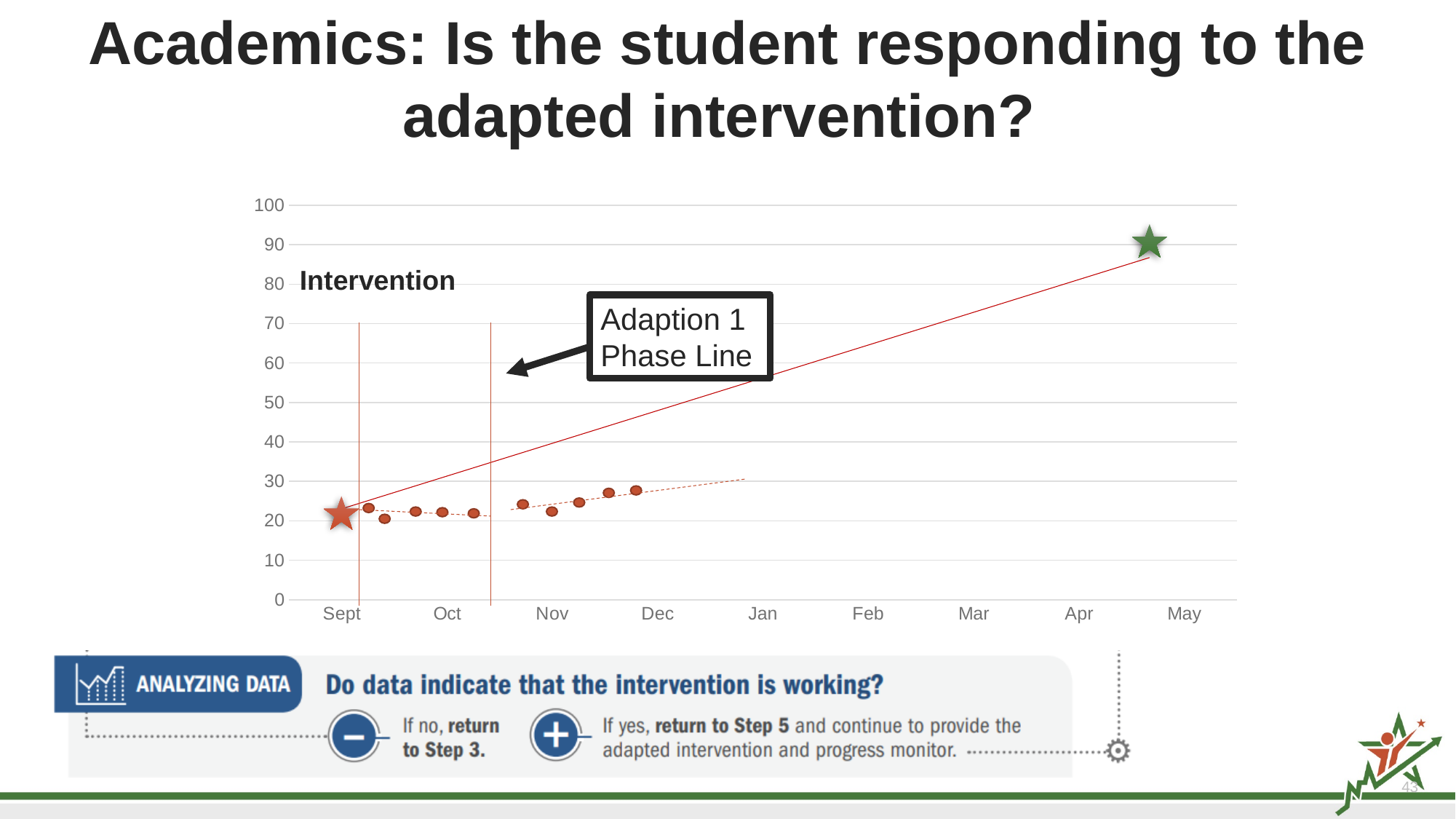
What label appears near the top left of the plot area, next to the 80 gridline? Intervention How many months are labelled along the x axis? 9 Which is higher, the green star near May or the orange star at Sept? the green star near May Are all of the orange data points plotted between Sept and Dec greater or less than 40? less What is the highest value shown on the y axis? 100 Between which two x-axis months is the Adaption 1 Phase Line drawn? Oct and Nov What is the label in the boxed callout pointing to the vertical orange line? Adaption 1 Phase Line What is the last month labelled on the x axis? May Is the value of the orange star at Sept greater or less than 30? less Do the orange data points after the Adaption 1 Phase Line rise or fall as they move toward Dec? rise Is the value of the green star near May greater or less than 80? greater What is the first month labelled on the x axis? Sept